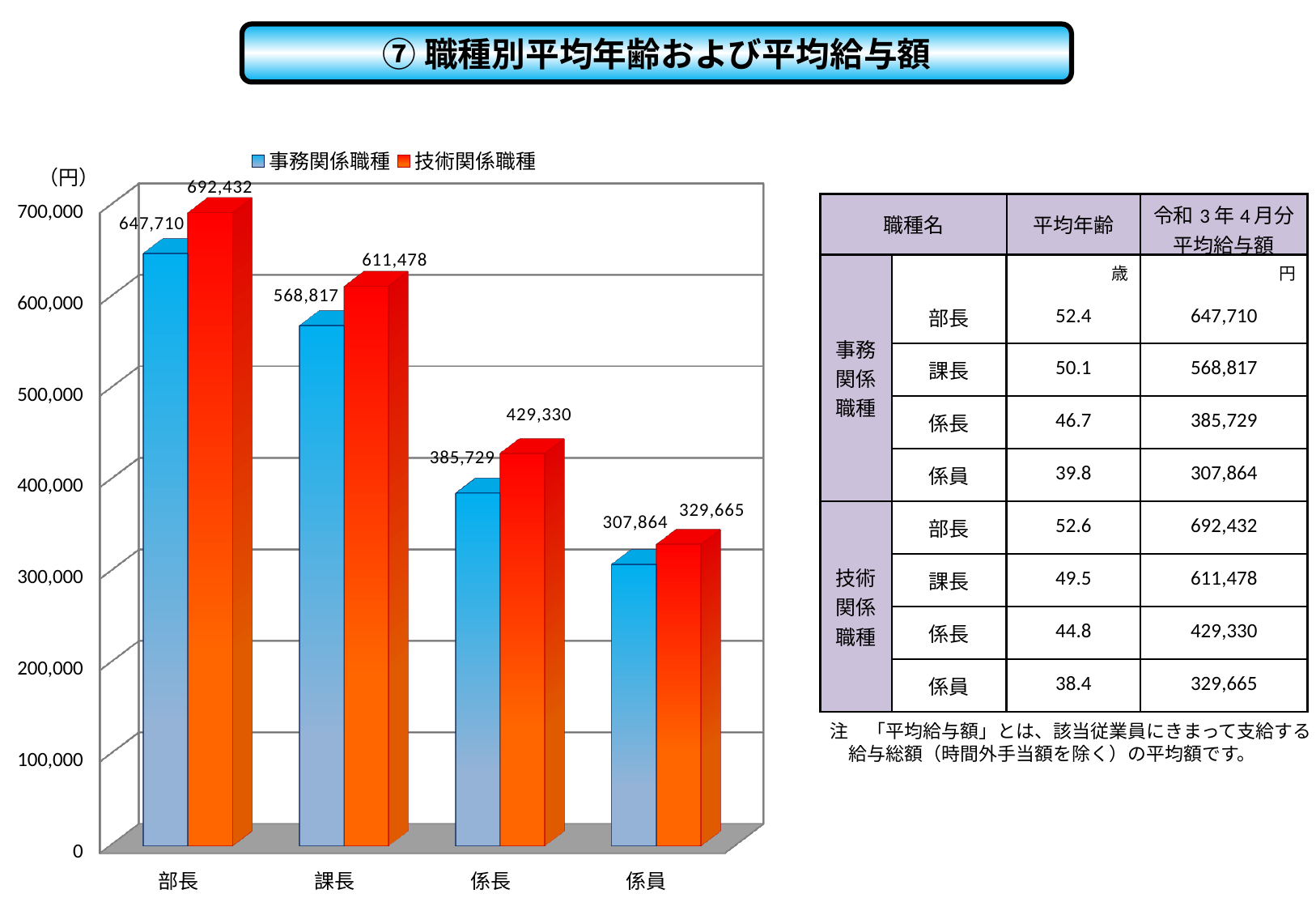
What is the value for 技術関係職種 in the 係長 category? 429,330 Which category has the highest value for 技術関係職種? 部長 What is the value for 技術関係職種 in the 係員 category? 329,665 What is the difference between 技術関係職種 and 事務関係職種 in the 課長 category? 42,661 Which category has the lowest value for 事務関係職種? 係員 What is the value for 事務関係職種 in the 部長 category? 647,710 How many categories are shown on the x axis of the chart? 4 Do the values for 事務関係職種 rise or fall from 部長 to 係員 along the x axis? fall How many series does the chart legend list? 2 Is the value for 事務関係職種 in the 課長 category greater or less than 500,000? greater What kind of chart is shown on the slide? bar chart Which is larger in the 係長 category, 事務関係職種 or 技術関係職種? 技術関係職種